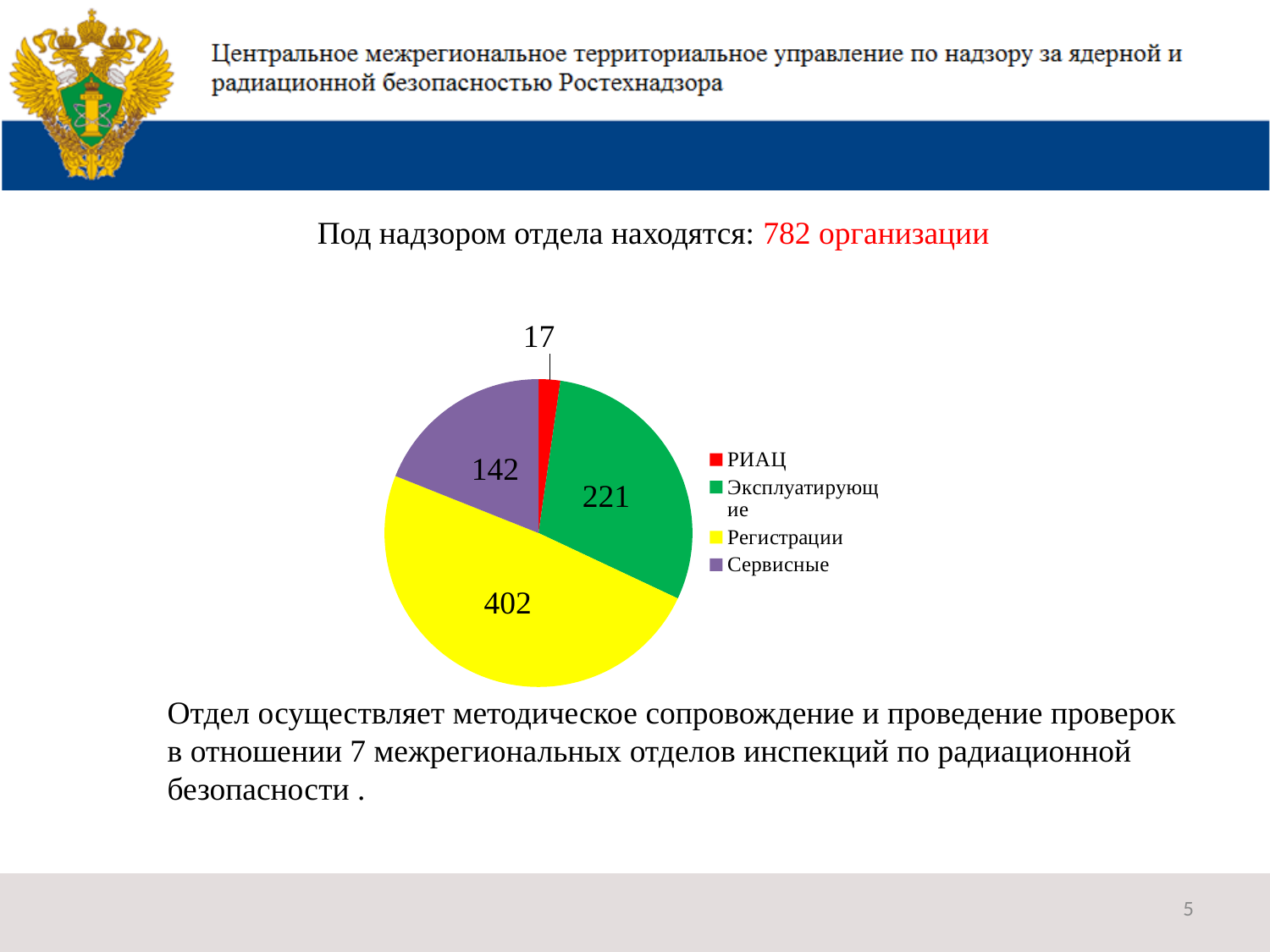
What is the value for РИАЦ in the pie chart? 17 Which is larger, the value for Эксплуатирующие or the value for Сервисные? Эксплуатирующие Which category has the smallest slice in the pie chart? РИАЦ What type of chart is shown on the slide? pie chart What is the value for Регистрации in the pie chart? 402 Which category has the largest slice in the pie chart? Регистрации What is the difference between the values for Регистрации and Эксплуатирующие? 181 Which colour represents Сервисные in the pie chart? purple What is the value for Сервисные in the pie chart? 142 What is the value for Эксплуатирующие in the pie chart? 221 How many entries does the legend of the pie chart list? 4 How many slices does the pie chart have? 4